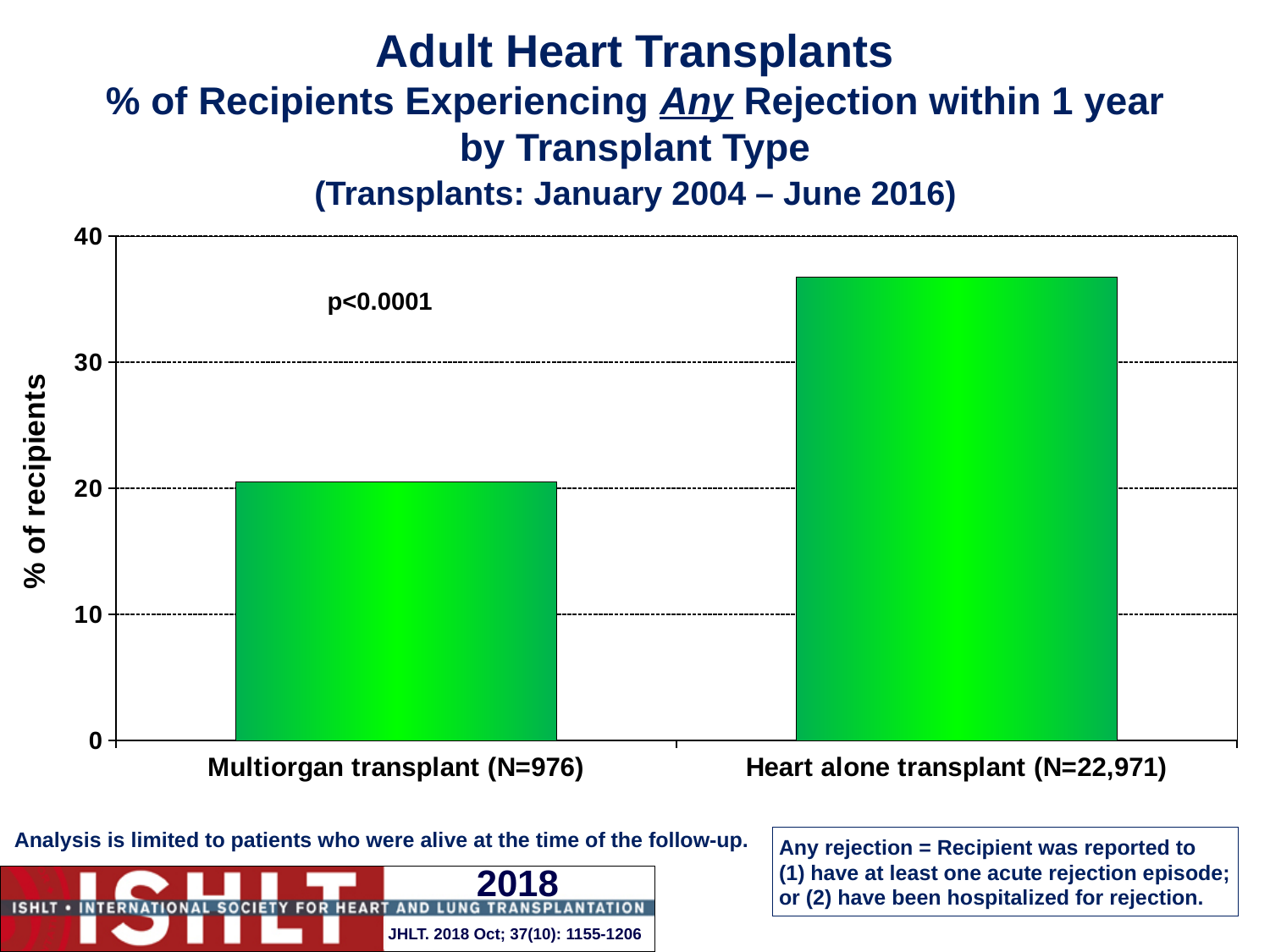
What p-value is printed on the chart? p<0.0001 Is the value for Heart alone transplant greater or less than 30? greater Which transplant type has the lower percentage of recipients experiencing any rejection within 1 year? Multiorgan transplant (N=976) Which transplant type has the higher percentage of recipients experiencing any rejection within 1 year? Heart alone transplant (N=22,971) What type of chart is shown on the slide? bar chart Is the value for Heart alone transplant greater or less than 40? less Is the value for Multiorgan transplant greater or less than 30? less What is the label of the y axis? % of recipients Which is larger: the value for Multiorgan transplant or the value for Heart alone transplant? Heart alone transplant How many transplant type categories are plotted on the chart? 2